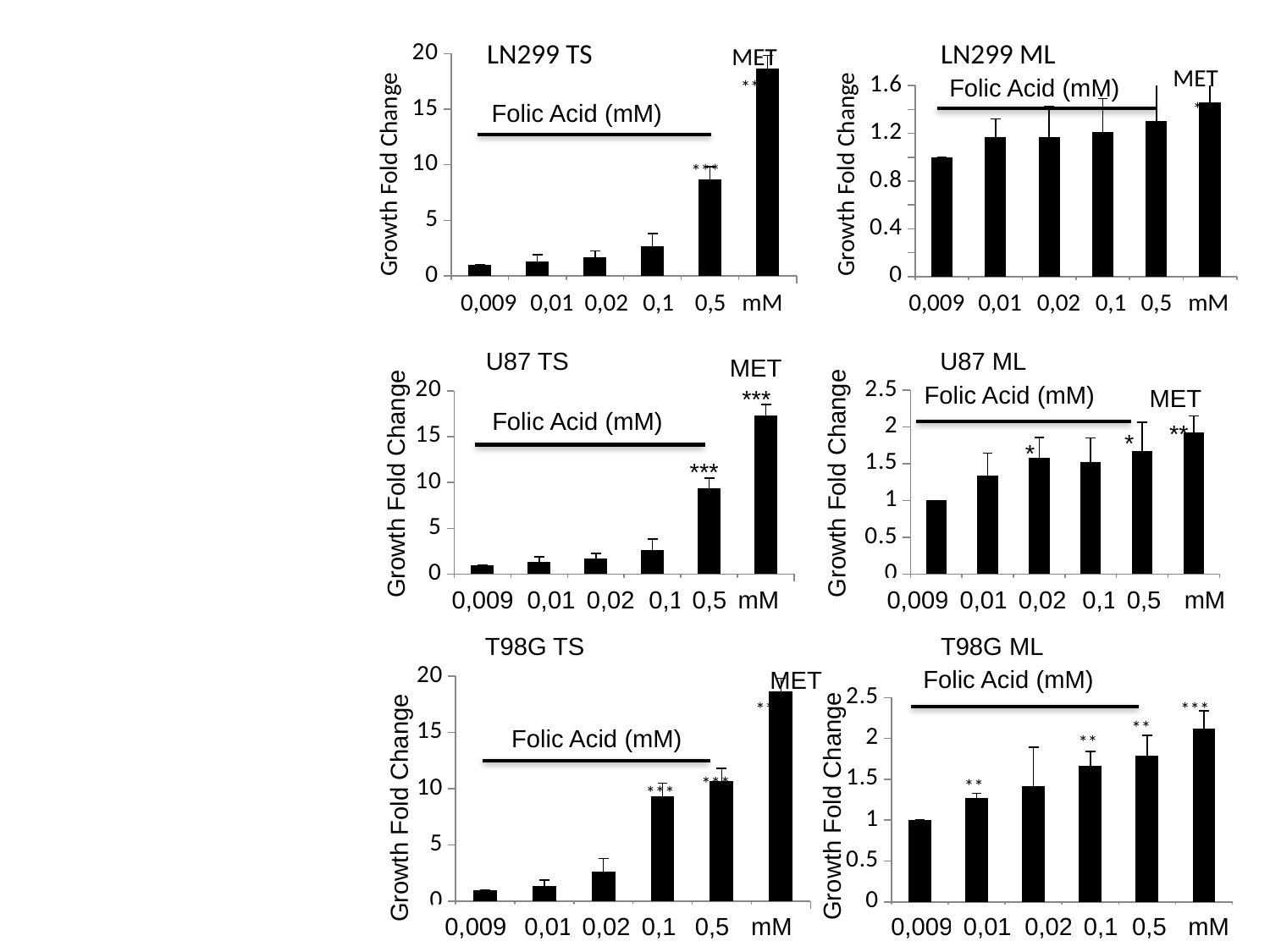
In the T98G ML chart, do the bar values generally rise or fall from left to right along the x axis? rise In the T98G TS chart, which is larger, the bar for 0,02 or the bar for 0,1? 0,1 In the U87 ML chart, which category has the highest bar? mM (MET) In the LN299 ML chart, which category has the lowest bar? 0,009 In the LN299 TS chart, which category has the highest bar? mM (MET) In the U87 TS chart, is the value for mM (MET) greater or less than 15? greater How many bars are plotted in the LN299 ML chart? 6 In the U87 TS chart, which is larger, the bar for 0,5 or the bar for 0,1? 0,5 In the U87 ML chart, is the value for 0,009 greater or less than 1.5? less What kind of chart is the LN299 TS chart? bar chart What is the y-axis title of the T98G ML chart? Growth Fold Change In the LN299 TS chart, is the value for 0,5 greater or less than 5? greater